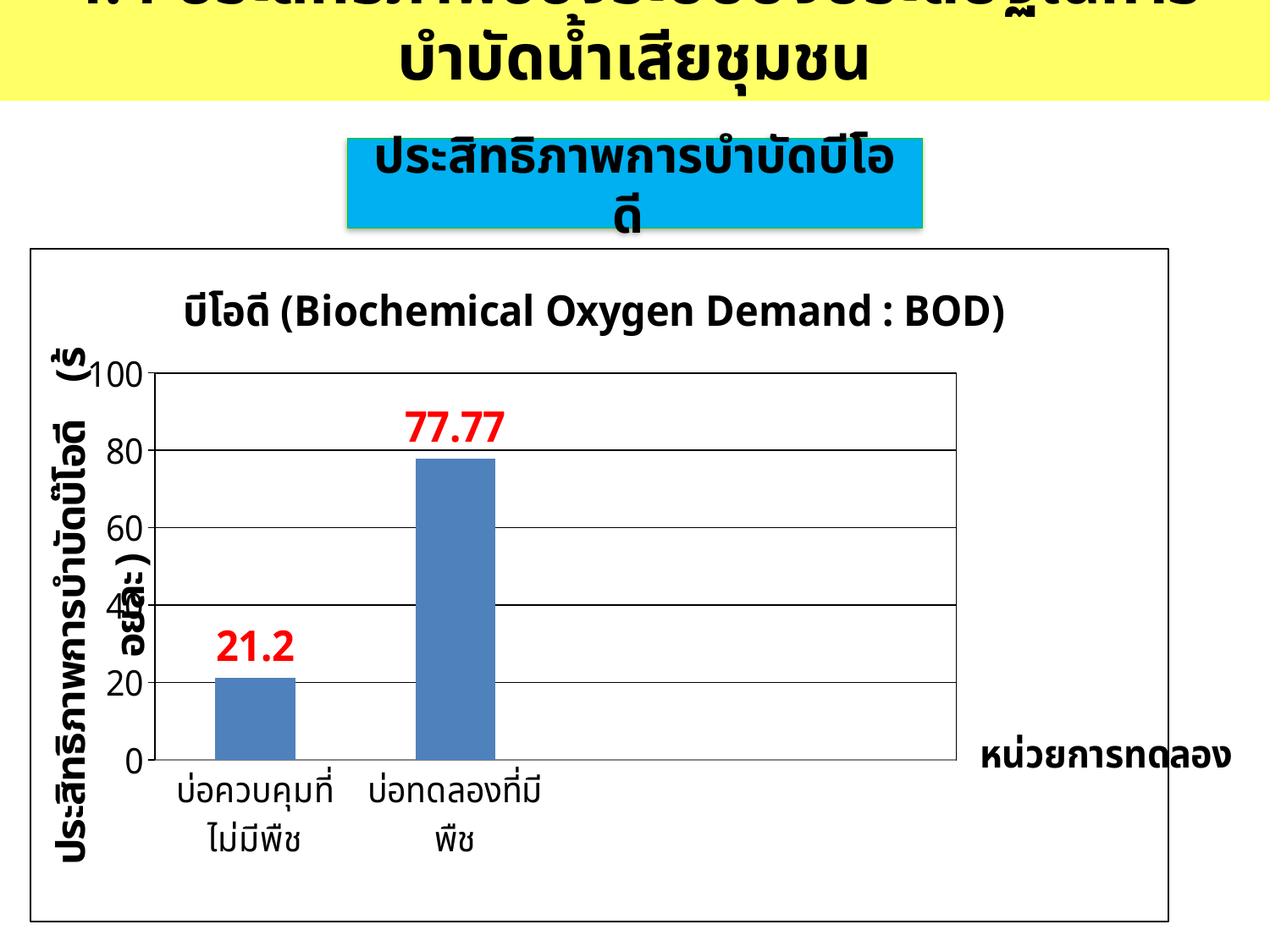
How many categories are shown on the x axis? 2 Which is larger, the value for บ่อควบคุมที่ไม่มีพืช or the value for บ่อทดลองที่มีพืช? บ่อทดลองที่มีพืช Is the value for บ่อควบคุมที่ไม่มีพืช greater or less than 40? less What is the title of the chart? บีโอดี (Biochemical Oxygen Demand : BOD) Is the value for บ่อทดลองที่มีพืช greater or less than 60? greater What is the value for บ่อทดลองที่มีพืช? 77.77 What is the maximum value shown on the y axis? 100 Which category has the highest value? บ่อทดลองที่มีพืช Which category has the lowest value? บ่อควบคุมที่ไม่มีพืช What is the value for บ่อควบคุมที่ไม่มีพืช? 21.2 What kind of chart is shown? bar chart What is the difference between the values for บ่อทดลองที่มีพืช and บ่อควบคุมที่ไม่มีพืช? 56.57